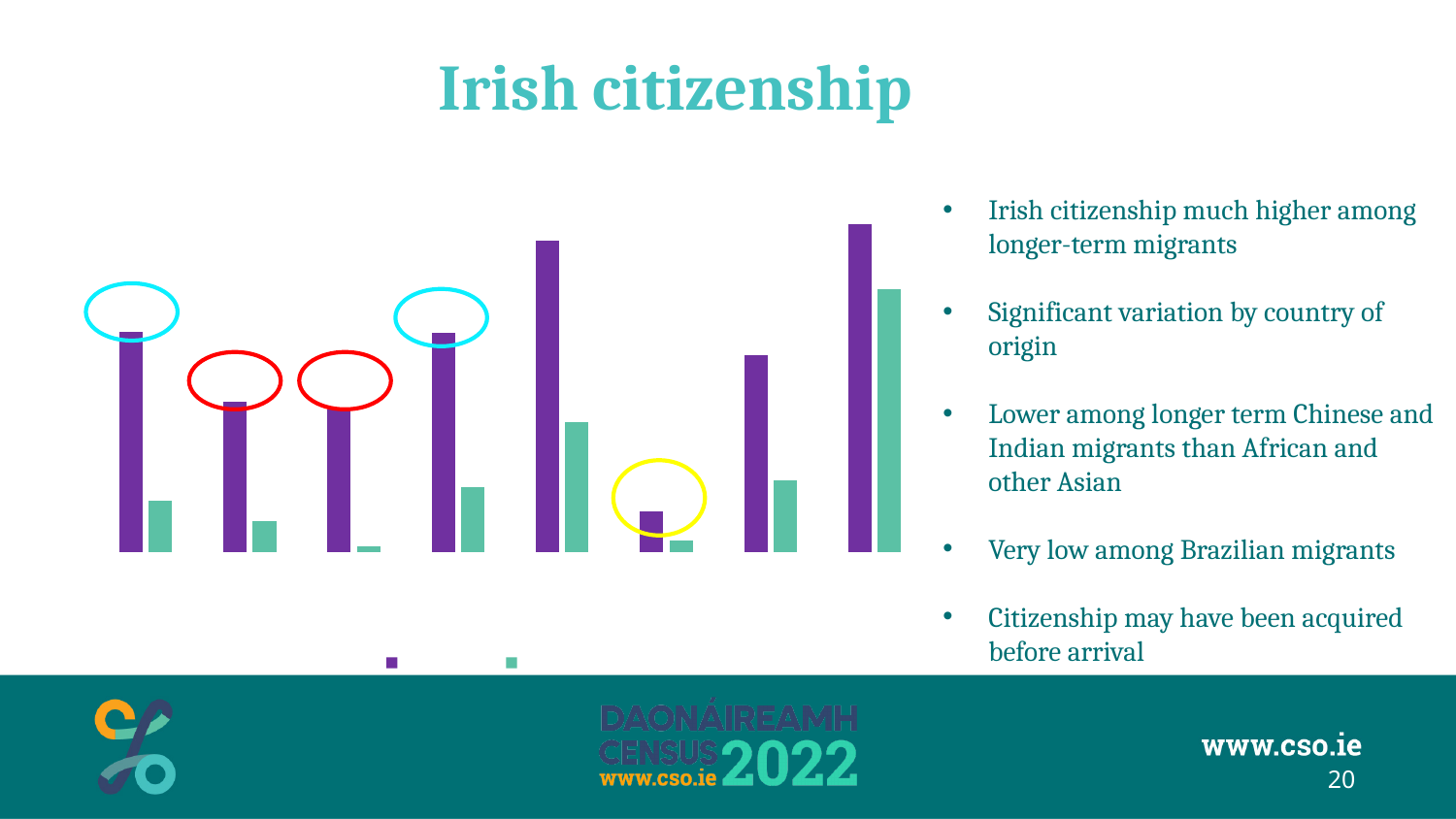
How many groups of bars are plotted in the chart? 8 Is the purple bar in the 5th group from the left taller or shorter than the purple bar in the 7th group? Taller What kind of chart is shown on the slide? Bar chart Which group of bars, counting from the left, has the shortest purple bar? The 6th group In the leftmost group of bars, is the purple bar or the green bar taller? Purple Which group of bars, counting from the left, has the tallest purple bar? The 8th (rightmost) group How many series does the chart's legend list? 2 In the rightmost group of bars, is the purple bar or the green bar taller? Purple What two colours are used for the bars in the chart? Purple and green Which group of bars, counting from the left, has the tallest green bar? The 8th (rightmost) group How many groups of bars are circled in red on the chart? 2